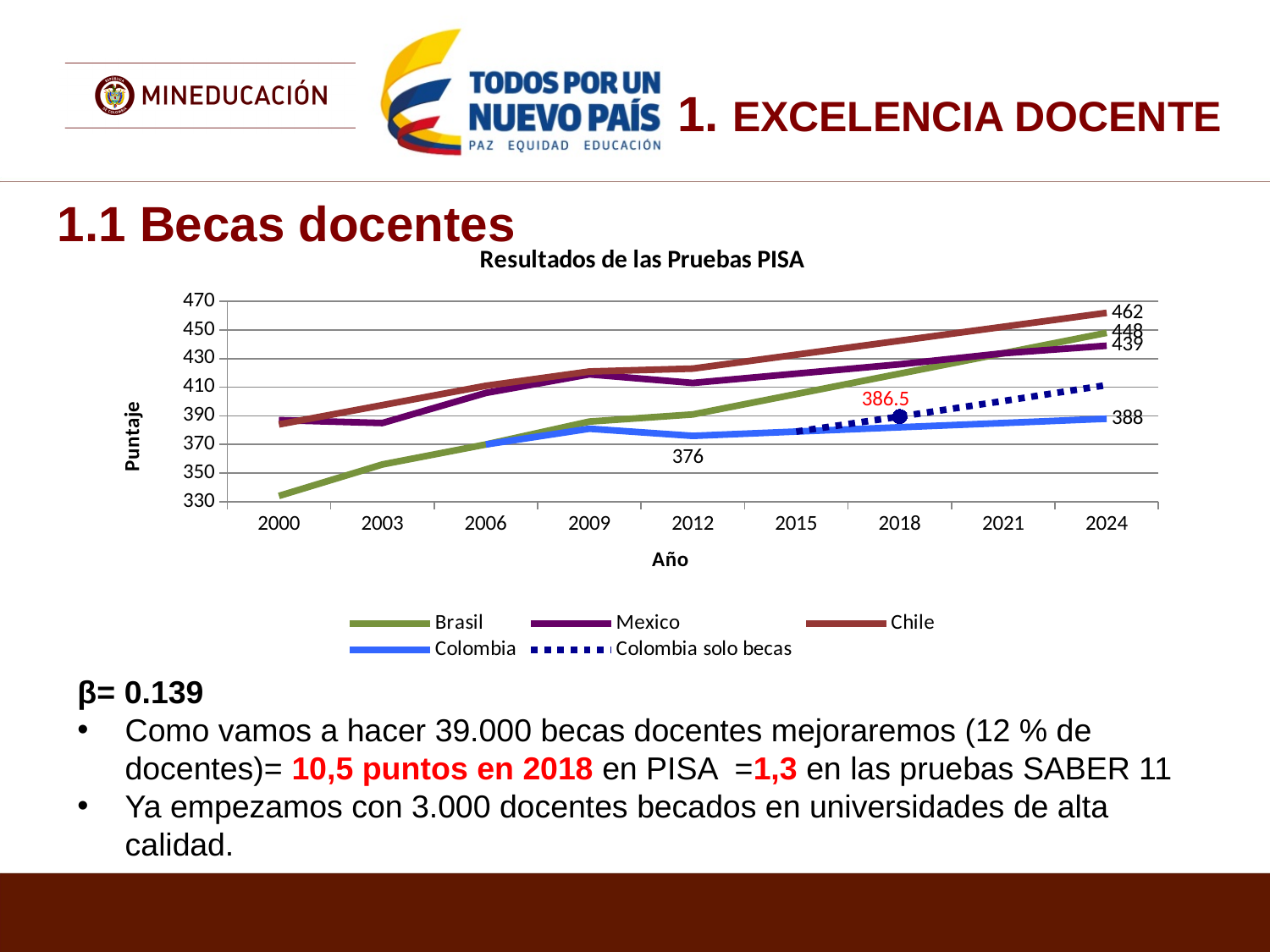
What is the difference between the 2024 values for Chile and Colombia in the PISA chart? 74 What kind of chart is shown under the title "Resultados de las Pruebas PISA"? line chart How many series does the legend of the PISA chart list? 5 What is the value for Brasil in 2024 in the PISA chart? 448 What value is labelled for Colombia in 2012 in the PISA chart? 376 Is the value for Brasil in 2000 greater or less than 350 in the PISA chart? less Which series has the highest value in 2024 in the PISA chart? Chile What is the value for Mexico in 2024 in the PISA chart? 439 Does the Brasil line rise or fall from 2000 to 2024 in the PISA chart? rises What is the value for Colombia in 2024 in the PISA chart? 388 What is the value for Chile in 2024 in the PISA chart? 462 What value is labelled for the "Colombia solo becas" series in 2018? 386.5